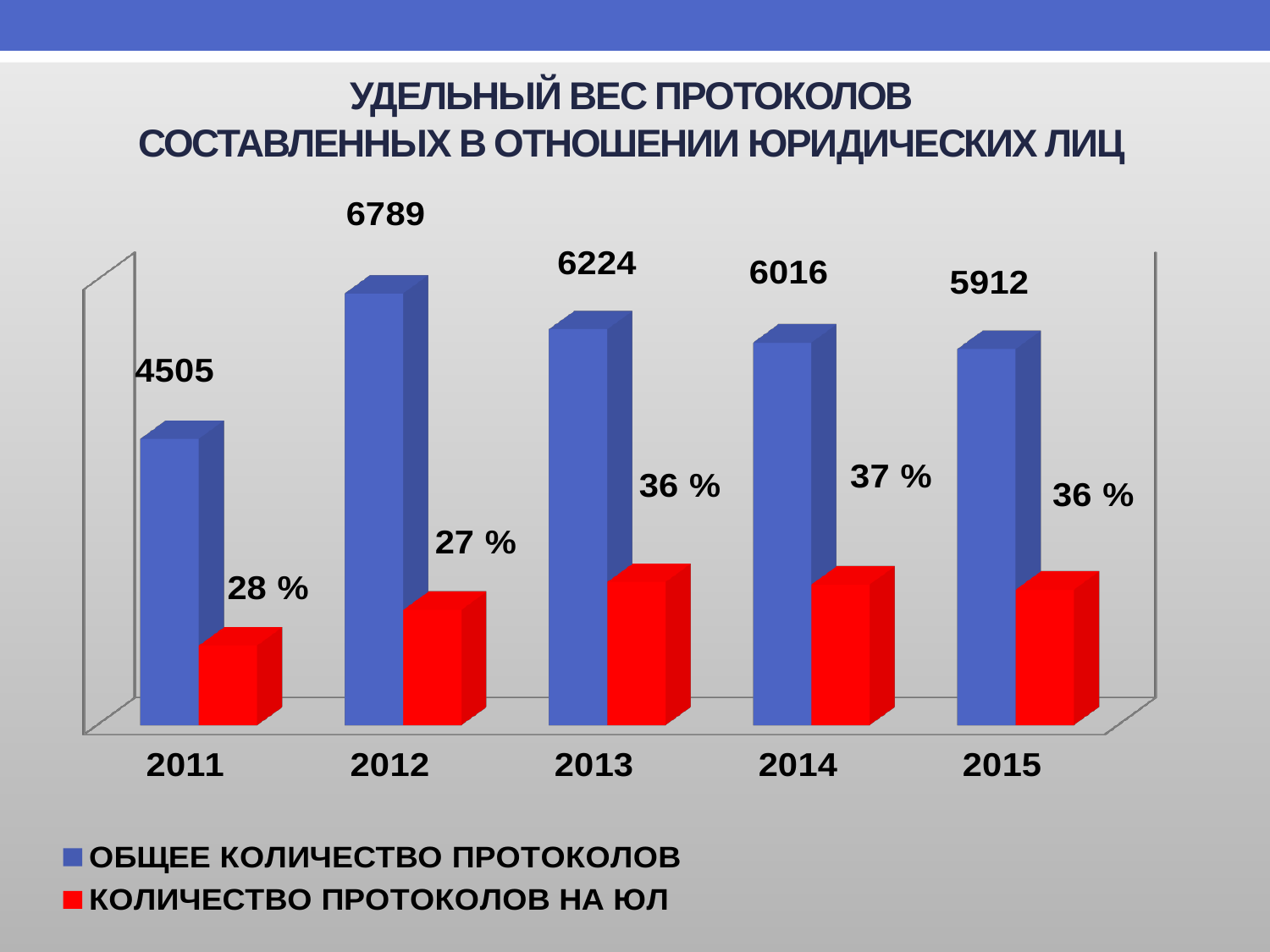
What is the value of ОБЩЕЕ КОЛИЧЕСТВО ПРОТОКОЛОВ for 2015? 5912 In which year is ОБЩЕЕ КОЛИЧЕСТВО ПРОТОКОЛОВ the lowest? 2011 Which year has a larger ОБЩЕЕ КОЛИЧЕСТВО ПРОТОКОЛОВ, 2013 or 2014? 2013 What label is shown on the КОЛИЧЕСТВО ПРОТОКОЛОВ НА ЮЛ bar for 2011? 28 % In which year is ОБЩЕЕ КОЛИЧЕСТВО ПРОТОКОЛОВ the highest? 2012 What label is shown on the КОЛИЧЕСТВО ПРОТОКОЛОВ НА ЮЛ bar for 2014? 37 % How many series does the legend list? 2 What is the value of ОБЩЕЕ КОЛИЧЕСТВО ПРОТОКОЛОВ for 2012? 6789 How many years are shown on the x axis? 5 What is the difference between ОБЩЕЕ КОЛИЧЕСТВО ПРОТОКОЛОВ in 2012 and in 2013? 565 What kind of chart is shown on the slide? bar chart In which year is the КОЛИЧЕСТВО ПРОТОКОЛОВ НА ЮЛ percentage label the lowest? 2012